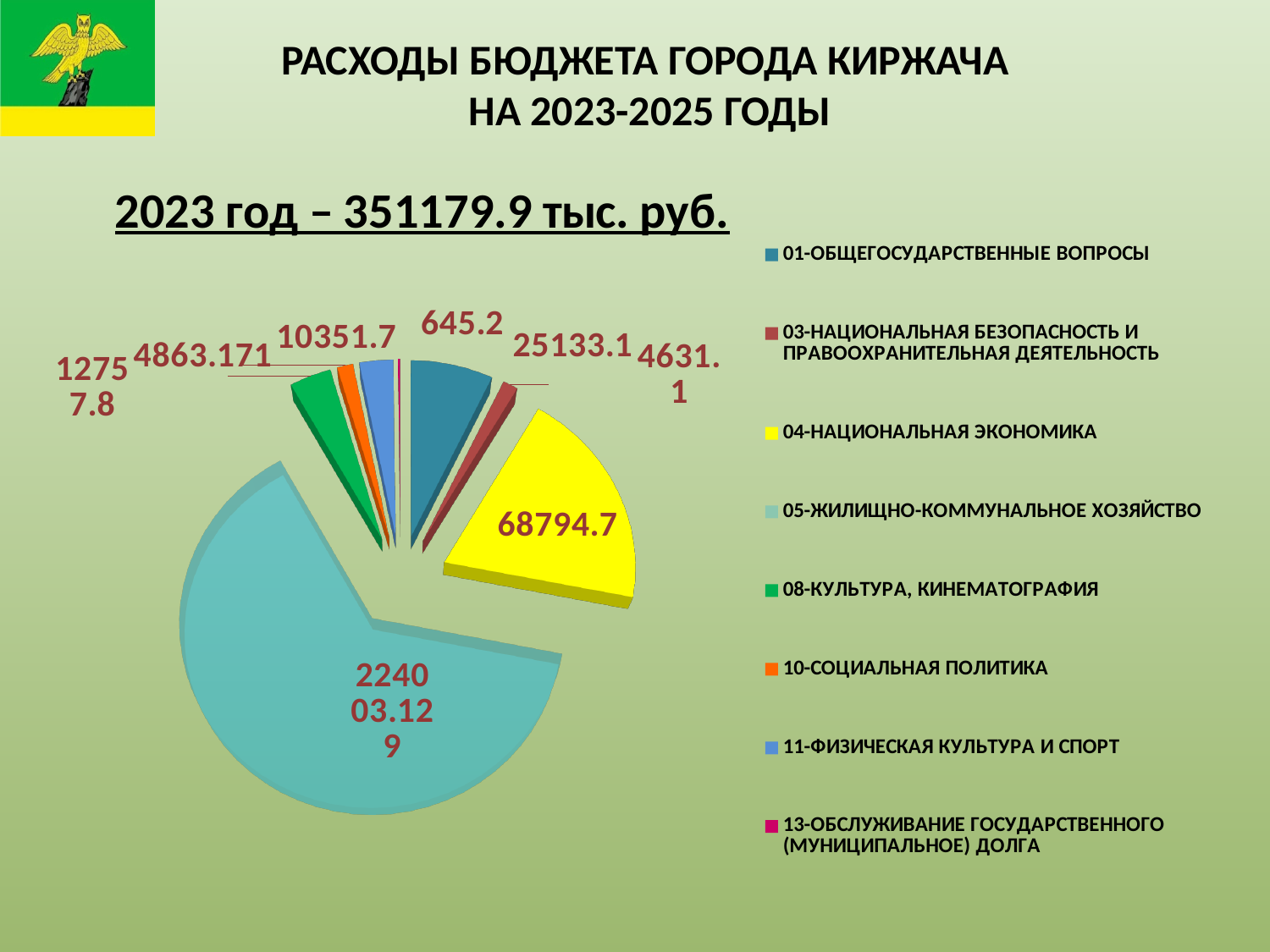
What is the value shown for 11-ФИЗИЧЕСКАЯ КУЛЬТУРА И СПОРТ? 10351.7 What is the difference between the values for 04-НАЦИОНАЛЬНАЯ ЭКОНОМИКА and 01-ОБЩЕГОСУДАРСТВЕННЫЕ ВОПРОСЫ? 43661.6 What is the value shown for 04-НАЦИОНАЛЬНАЯ ЭКОНОМИКА? 68794.7 Which is larger: the value for 01-ОБЩЕГОСУДАРСТВЕННЫЕ ВОПРОСЫ or for 04-НАЦИОНАЛЬНАЯ ЭКОНОМИКА? 04-НАЦИОНАЛЬНАЯ ЭКОНОМИКА What kind of chart is shown on the slide? Pie chart What is the difference between the values for 08-КУЛЬТУРА, КИНЕМАТОГРАФИЯ and 11-ФИЗИЧЕСКАЯ КУЛЬТУРА И СПОРТ? 2406.1 How many categories does the legend of the pie chart list? 8 Which category has the smallest slice of the pie chart? 13-ОБСЛУЖИВАНИЕ ГОСУДАРСТВЕННОГО (МУНИЦИПАЛЬНОЕ) ДОЛГА What is the value shown for 05-ЖИЛИЩНО-КОММУНАЛЬНОЕ ХОЗЯЙСТВО? 224003.129 Which category has the largest slice of the pie chart? 05-ЖИЛИЩНО-КОММУНАЛЬНОЕ ХОЗЯЙСТВО What total for 2023 is stated in the heading above the pie chart? 351179.9 тыс. руб. What is the value shown for 01-ОБЩЕГОСУДАРСТВЕННЫЕ ВОПРОСЫ? 25133.1